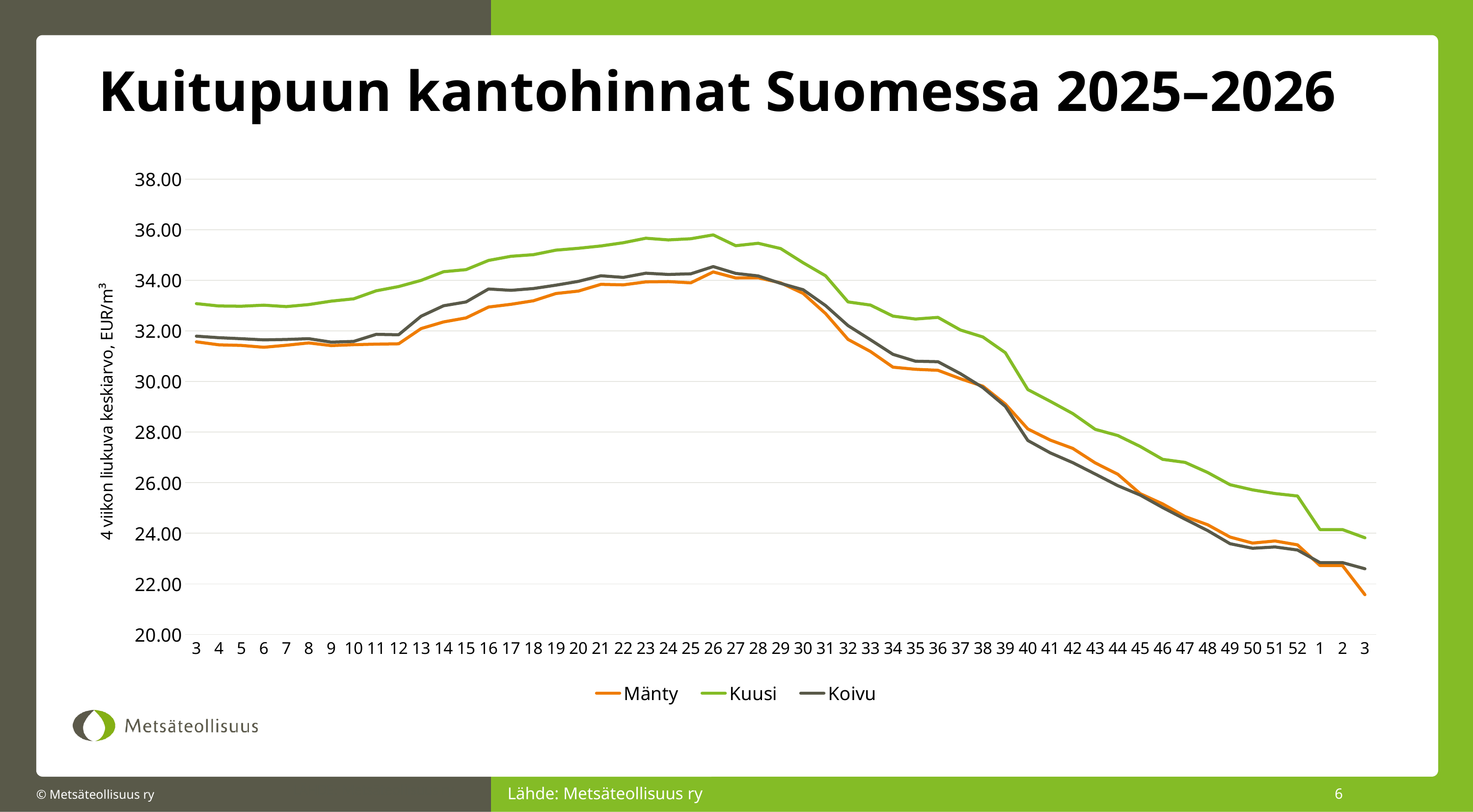
How many series does the legend list? 3 Which series is plotted in green? Kuusi Which series has the highest value at week 26, Kuusi or Mänty? Kuusi Is the value for Kuusi at week 26 greater or less than 34.00? greater At week 16, which is larger, Koivu or Mänty? Koivu Which series has the lowest value at the last week (3) on the x axis? Mänty Do the values for Kuusi rise or fall from week 30 to the end of the x axis? fall What kind of chart is shown on the slide? Line chart What is the title of the chart on the slide? Kuitupuun kantohinnat Suomessa 2025–2026 Is the value for Kuusi at week 52 greater or less than 26.00? less Is the value for Mänty at the last week (3) greater or less than 22.00? less